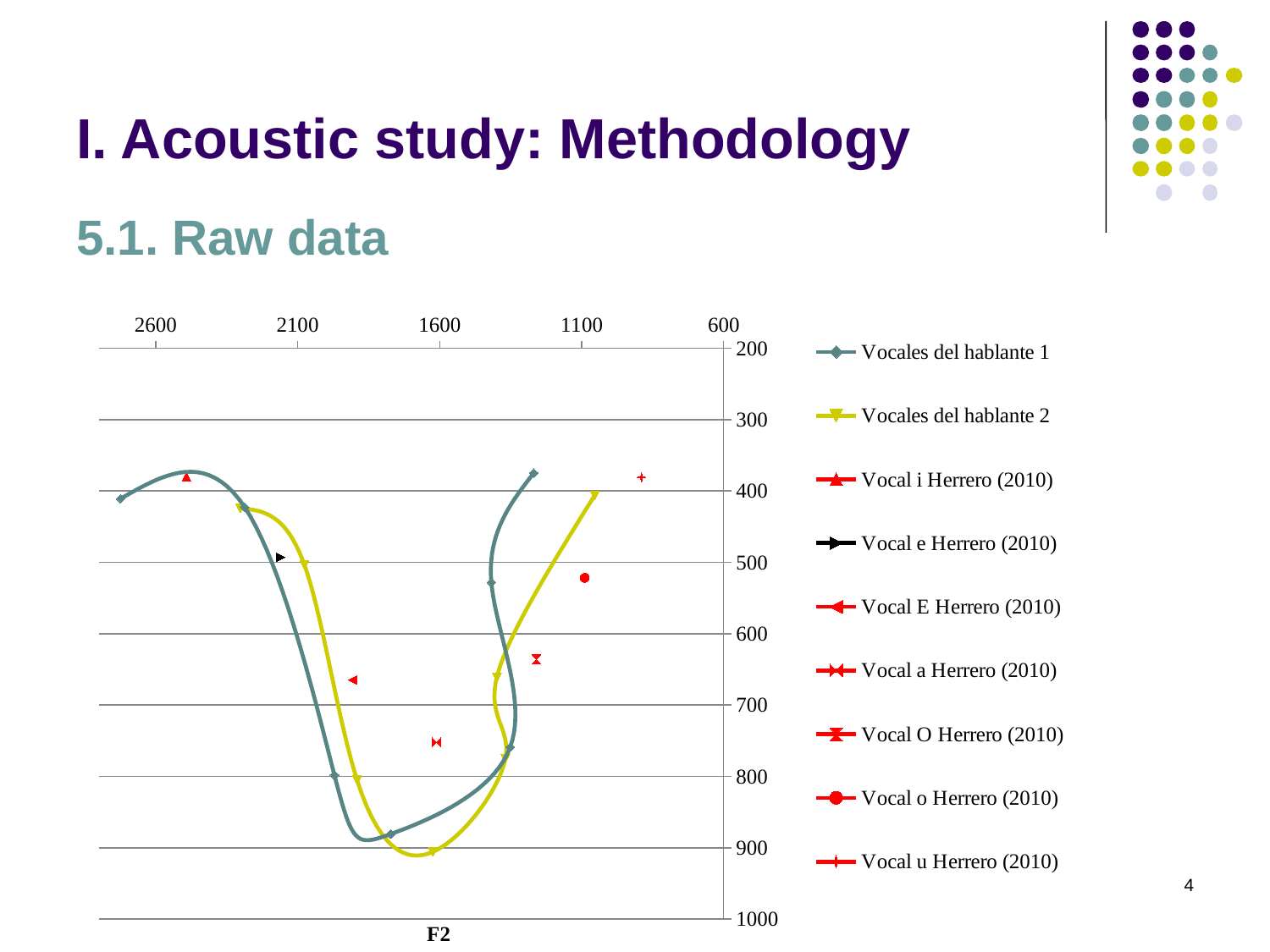
Is the F2 value for Vocal i Herrero (2010) greater or less than 2100? greater Is the vertical-axis value for Vocal a Herrero (2010) greater or less than 700? greater Is the F2 value for Vocal u Herrero (2010) greater or less than 1100? less What is the title of the horizontal axis? F2 How many series does the legend list? 9 Which has the larger vertical-axis value, Vocal i Herrero (2010) or Vocal o Herrero (2010)? Vocal o Herrero (2010) What is the last entry in the chart legend? Vocal u Herrero (2010) What kind of chart is shown on the slide? scatter chart with smoothed lines